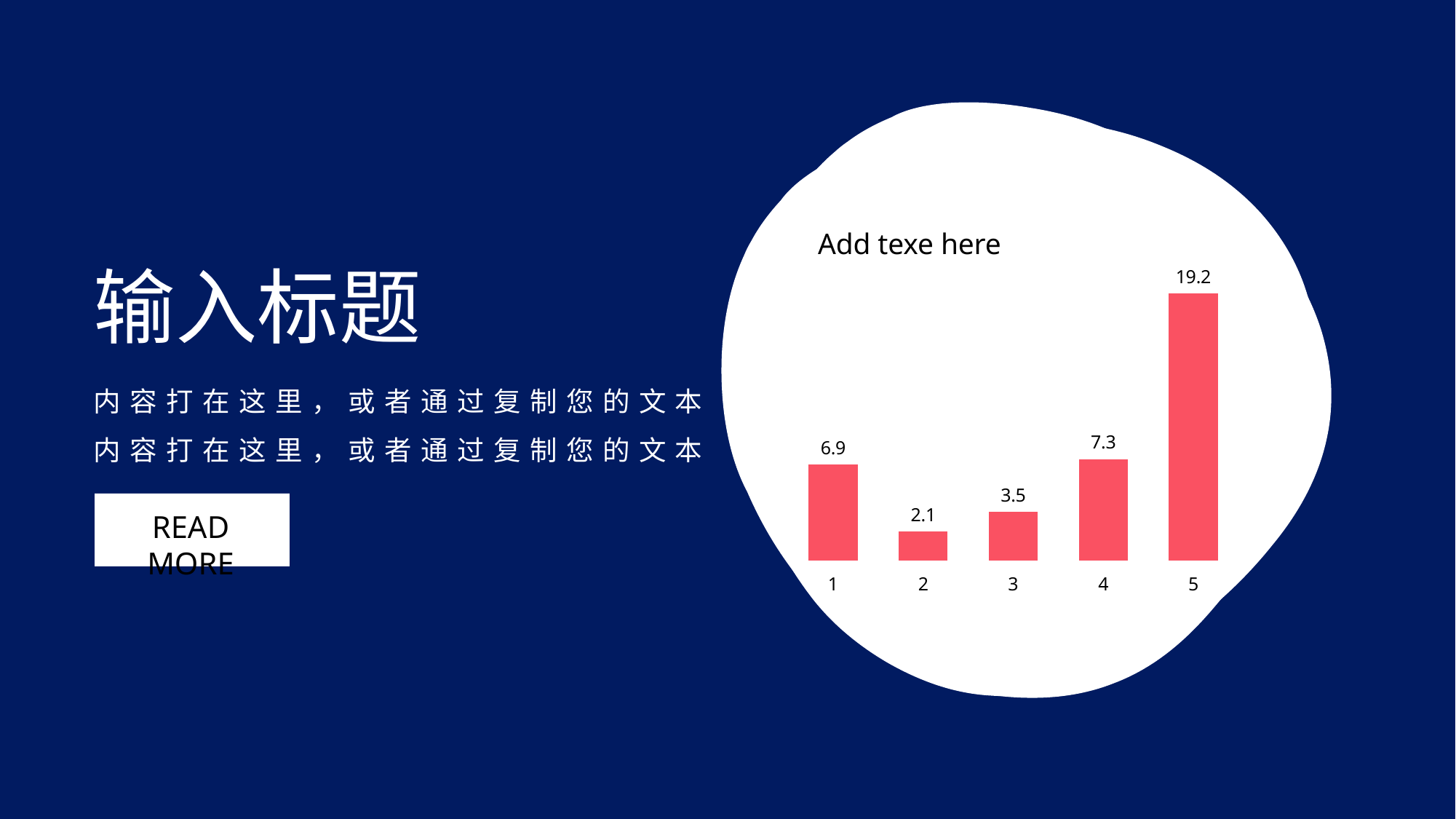
What is the title of the chart? Add texe here How many bars are in the chart? 5 What kind of chart is shown on the slide? bar chart Which category has the lowest value? 2 Which category has the highest value? 5 What is the difference between the values for category 5 and category 4? 11.9 What is the value for category 5? 19.2 What colour are the bars in the chart? red What is the value for category 3? 3.5 Which is larger, the value for category 4 or the value for category 1? 4 What is the value for category 1? 6.9 What is the difference between the values for category 1 and category 2? 4.8